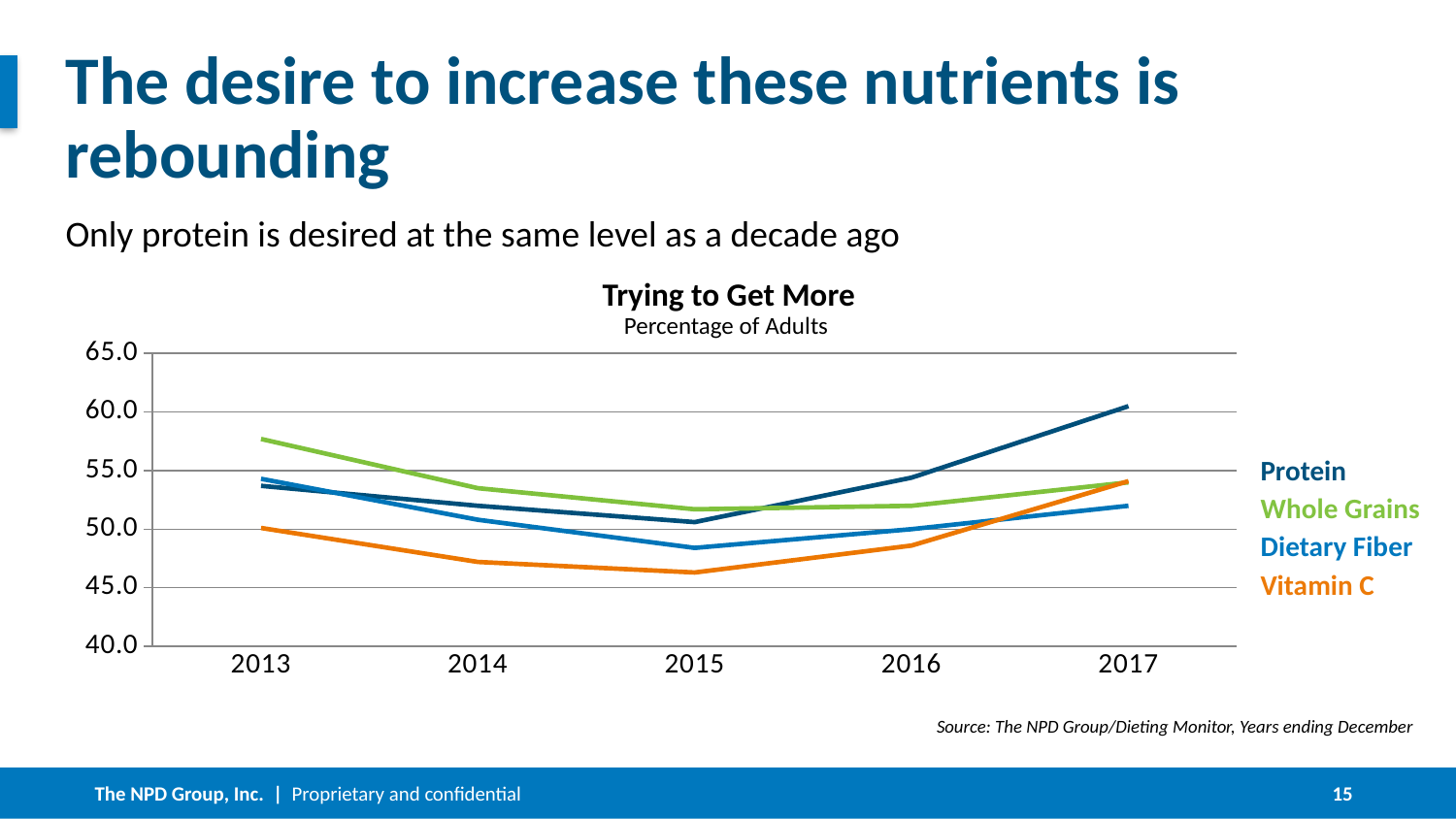
How many years are plotted along the x axis? 5 Which series has the highest value in 2013? Whole Grains Which series has the highest value in 2017? Protein Which series has the lowest value in 2013? Vitamin C Which series has the lowest value in 2017? Dietary Fiber Is the value for Whole Grains in 2013 greater or less than 55.0? greater What kind of chart is shown on the slide? line chart What is the title of the chart? Trying to Get More Does the Protein line rise or fall from 2015 to 2017? rise How many series does the chart's legend list? 4 Is the value for Vitamin C in 2015 greater or less than 50.0? less Does the Vitamin C line rise or fall from 2013 to 2015? fall